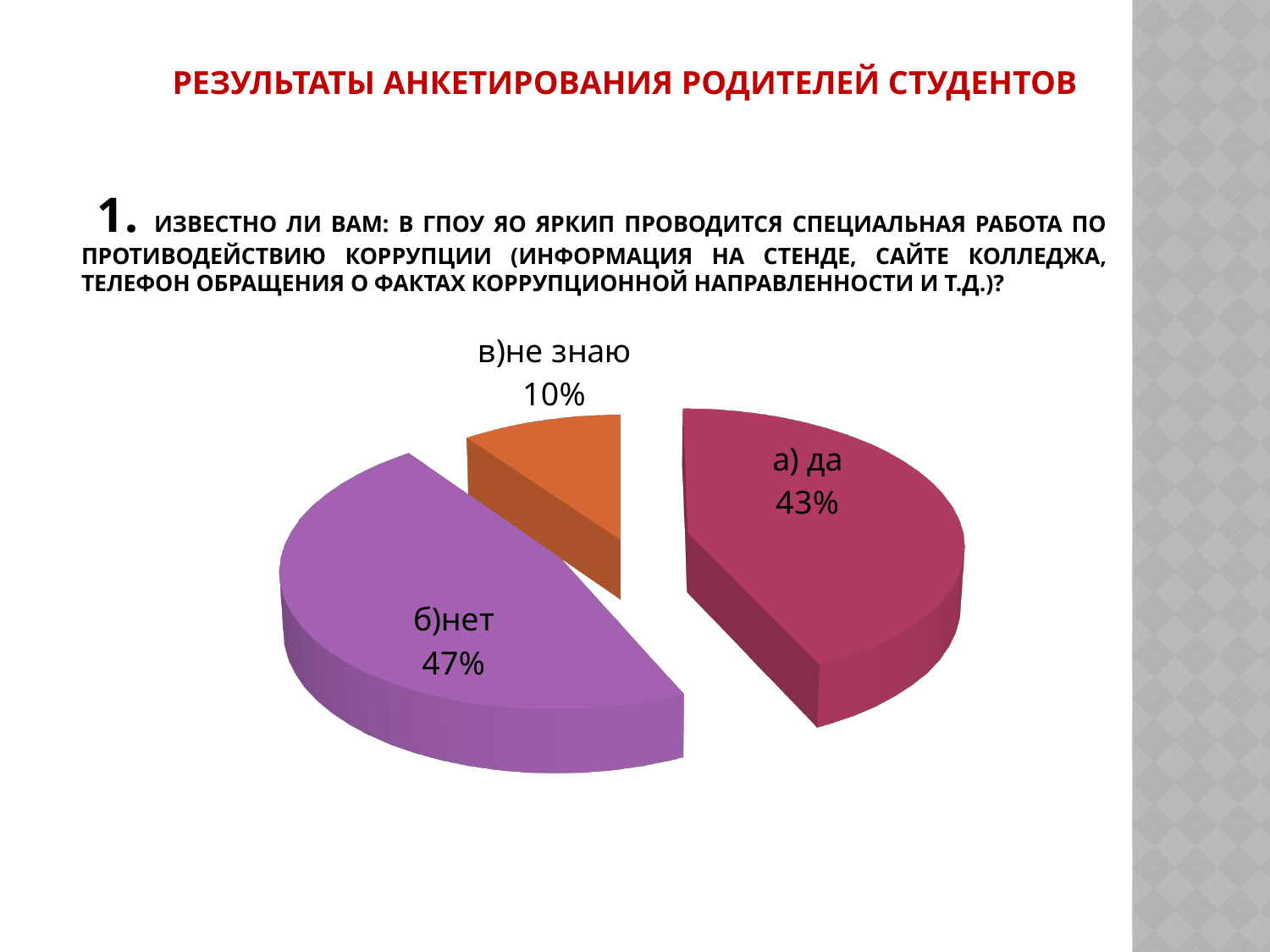
What is the difference in percentage points between the "б)нет" slice and the "а) да" slice? 4% What share of the pie does the slice "в)не знаю" represent? 10% Which slice of the pie is the smallest? в)не знаю What is the difference in percentage points between the "а) да" slice and the "в)не знаю" slice? 33% What kind of chart is shown on the slide? pie chart What share of the pie does the slice "б)нет" represent? 47% Which is larger, the "а) да" slice or the "в)не знаю" slice? а) да What colour is the "в)не знаю" slice of the pie? orange Which slice of the pie is the largest? б)нет How many slices does the pie chart have? 3 What colour is the "б)нет" slice of the pie? purple What share of the pie does the slice "а) да" represent? 43%